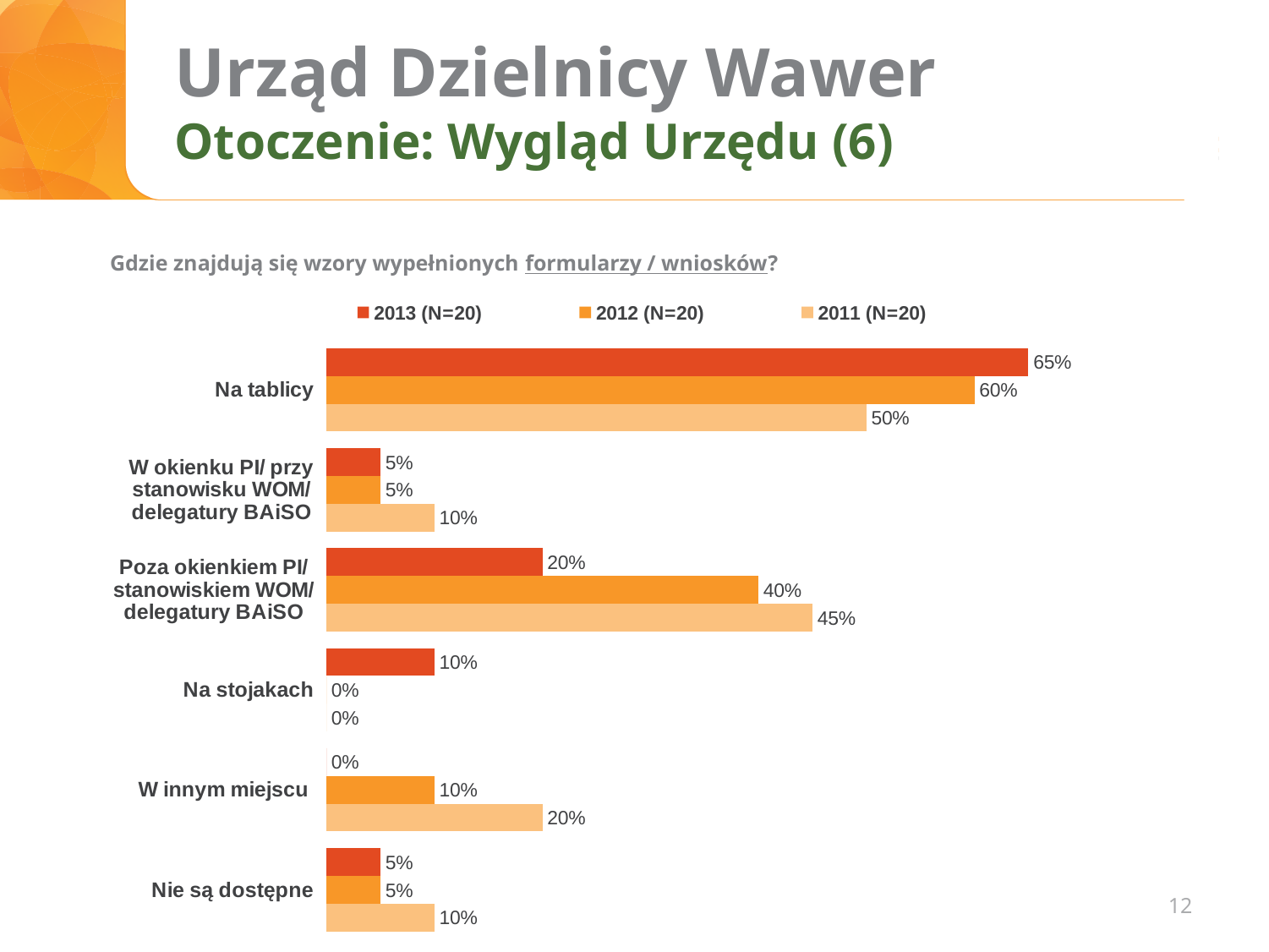
What kind of chart is shown on the slide? Bar chart Which category has the highest value in the 2011 (N=20) series? Na tablicy Which is larger for "W innym miejscu": the 2012 (N=20) value or the 2011 (N=20) value? 2011 (N=20) What is the difference between the 2013 (N=20) and 2011 (N=20) values for "Na tablicy"? 15% What is the value for "Na stojakach" in the 2013 (N=20) series? 10% How many series does the legend list? 3 What is the value for "W innym miejscu" in the 2011 (N=20) series? 20% What is the value for "Na tablicy" in the 2013 (N=20) series? 65% What is the value for "Poza okienkiem PI/ stanowiskiem WOM/ delegatury BAiSO" in the 2012 (N=20) series? 40% How many categories are shown on the chart? 6 What question does the chart answer, as stated above it? Gdzie znajdują się wzory wypełnionych formularzy / wniosków? What is the difference between the 2011 (N=20) and 2013 (N=20) values for "Poza okienkiem PI/ stanowiskiem WOM/ delegatury BAiSO"? 25%